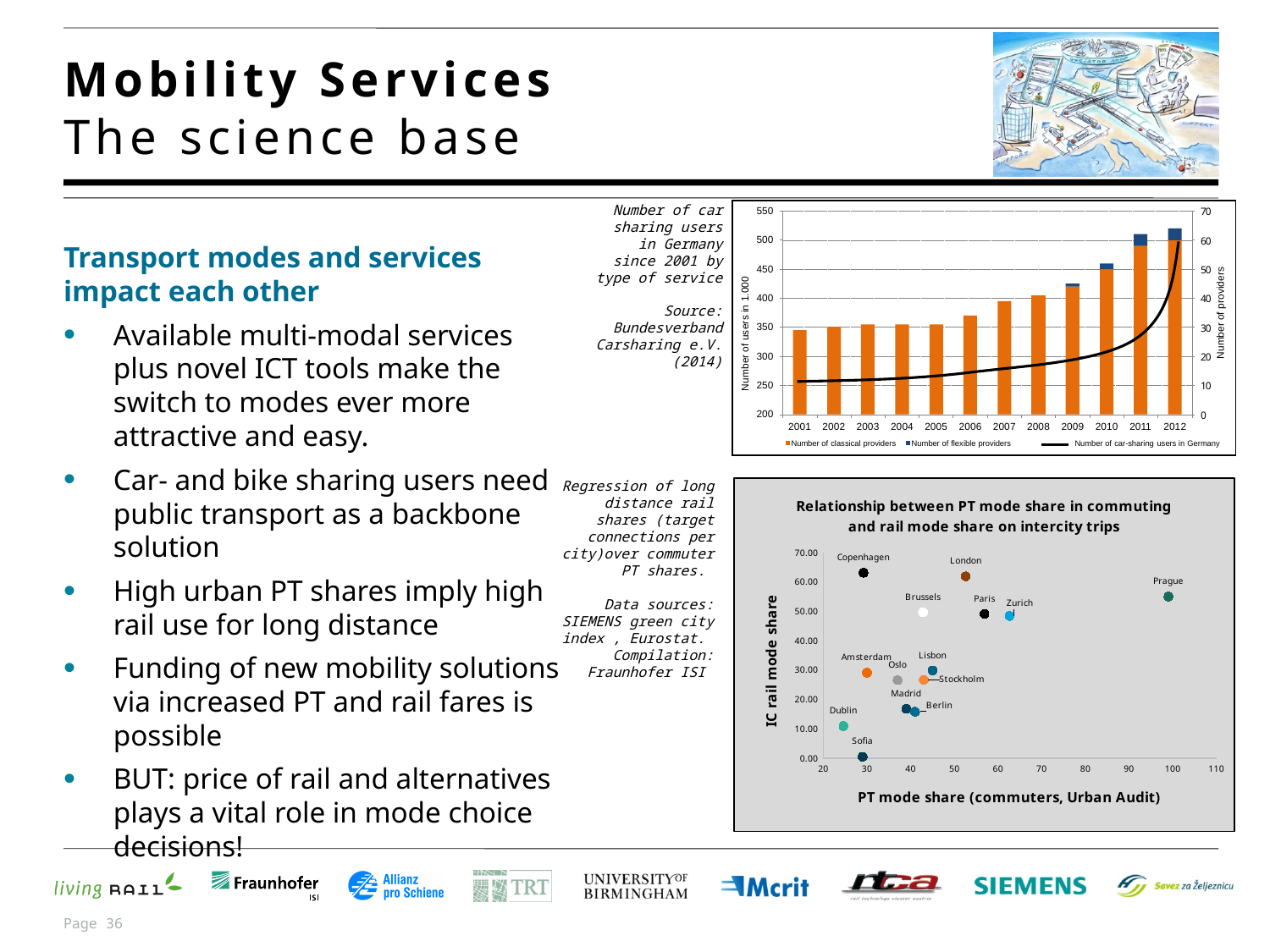
In the top chart (car sharing users in Germany), how many entries does the legend list? 3 In the bottom chart (Relationship between PT mode share and rail mode share), is the PT mode share for Prague greater or less than 90? greater In the top chart (car sharing users in Germany), which year has the shortest bar? 2001 In the top chart (car sharing users in Germany), which year has the tallest bar? 2012 In the bottom chart (Relationship between PT mode share and rail mode share), which city has the higher IC rail mode share, Paris or Amsterdam? Paris What kind of chart is the bottom chart (Relationship between PT mode share in commuting and rail mode share on intercity trips)? scatter chart In the top chart (car sharing users in Germany), does the line for the number of car-sharing users rise or fall from 2001 to 2012? rise In the bottom chart (Relationship between PT mode share and rail mode share), how many cities are plotted? 14 In the top chart (car sharing users in Germany), which series is shown as a line rather than bars? Number of car-sharing users in Germany In the bottom chart (Relationship between PT mode share and rail mode share), which city has the lowest IC rail mode share? Sofia In the top chart (car sharing users in Germany), how many years are shown on the x axis? 12 In the bottom chart (Relationship between PT mode share and rail mode share), which city has the highest PT mode share? Prague